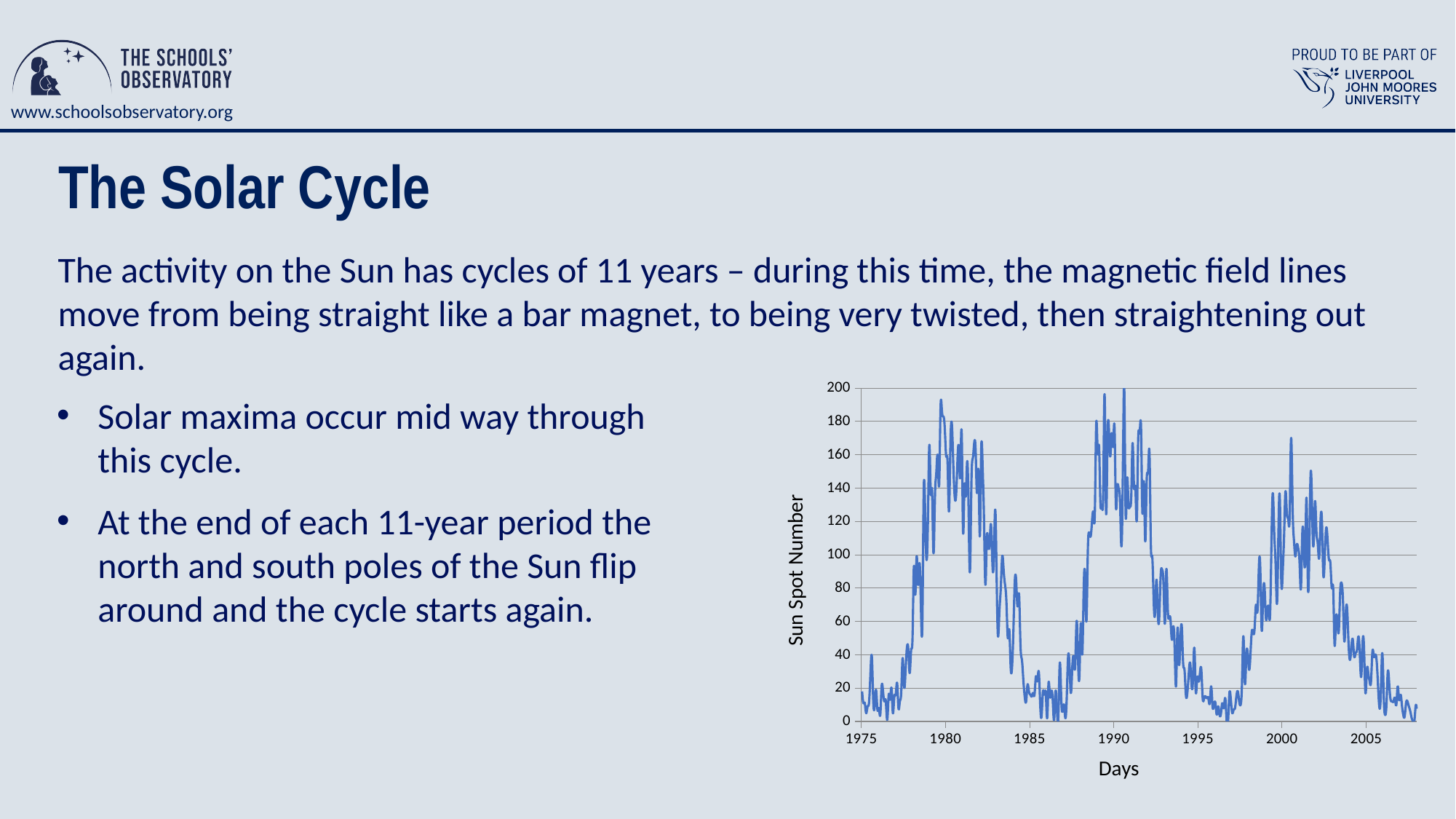
What kind of chart is shown on the slide? line chart Is the Sun Spot Number around 1996 greater or less than 40? less What is the label on the vertical axis of the chart? Sun Spot Number What is the label on the horizontal axis of the chart? Days Is the Sun Spot Number around 1986 greater or less than 40? less How many year labels are shown on the horizontal axis? 7 Does the Sun Spot Number rise or fall between 1991 and 1996? fall Is the Sun Spot Number around 1980 greater or less than 120? greater Does the Sun Spot Number rise or fall between 1975 and 1980? rise How many peaks (solar maxima) does the line show between 1975 and 2008? 3 Is the Sun Spot Number around 1990 larger or smaller than around 2000? larger